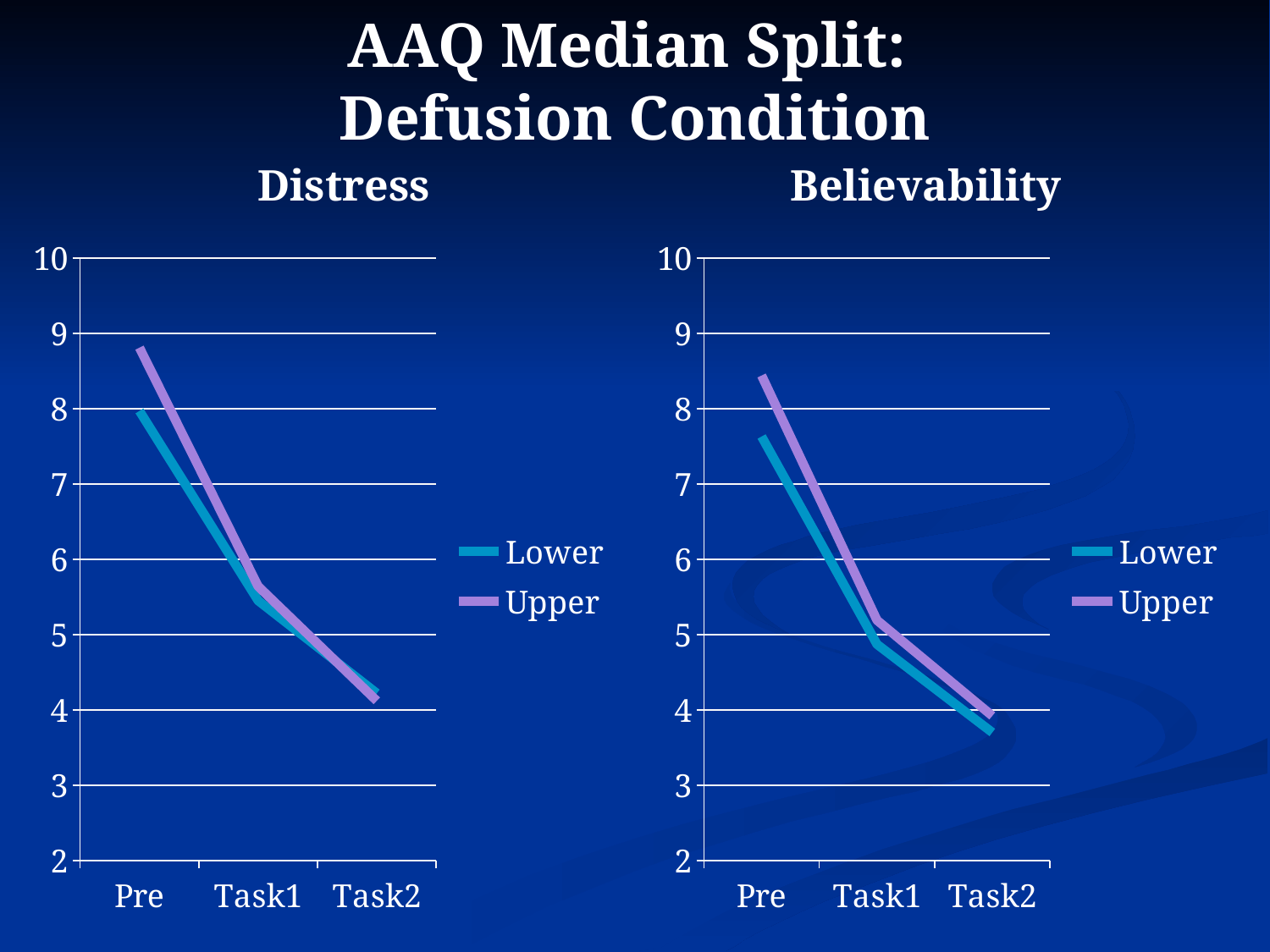
In the Believability chart, which series has the larger value at Pre, Lower or Upper? Upper How many points are plotted along the x axis of the Distress chart for each series? 3 In the Distress chart, at which point does the Upper series reach its highest value? Pre How many series does the legend of the Believability chart list? 2 In the Believability chart, do the values of the Lower series rise or fall from Pre to Task2? fall In the Believability chart, is the Lower value at Task2 greater or less than 4? less In the Distress chart, is the Lower value at Task1 greater or less than 6? less In the Believability chart, is the Lower value at Pre greater or less than 8? less What type of chart is the Distress chart? line chart In the Distress chart, which series has the larger value at Pre, Lower or Upper? Upper